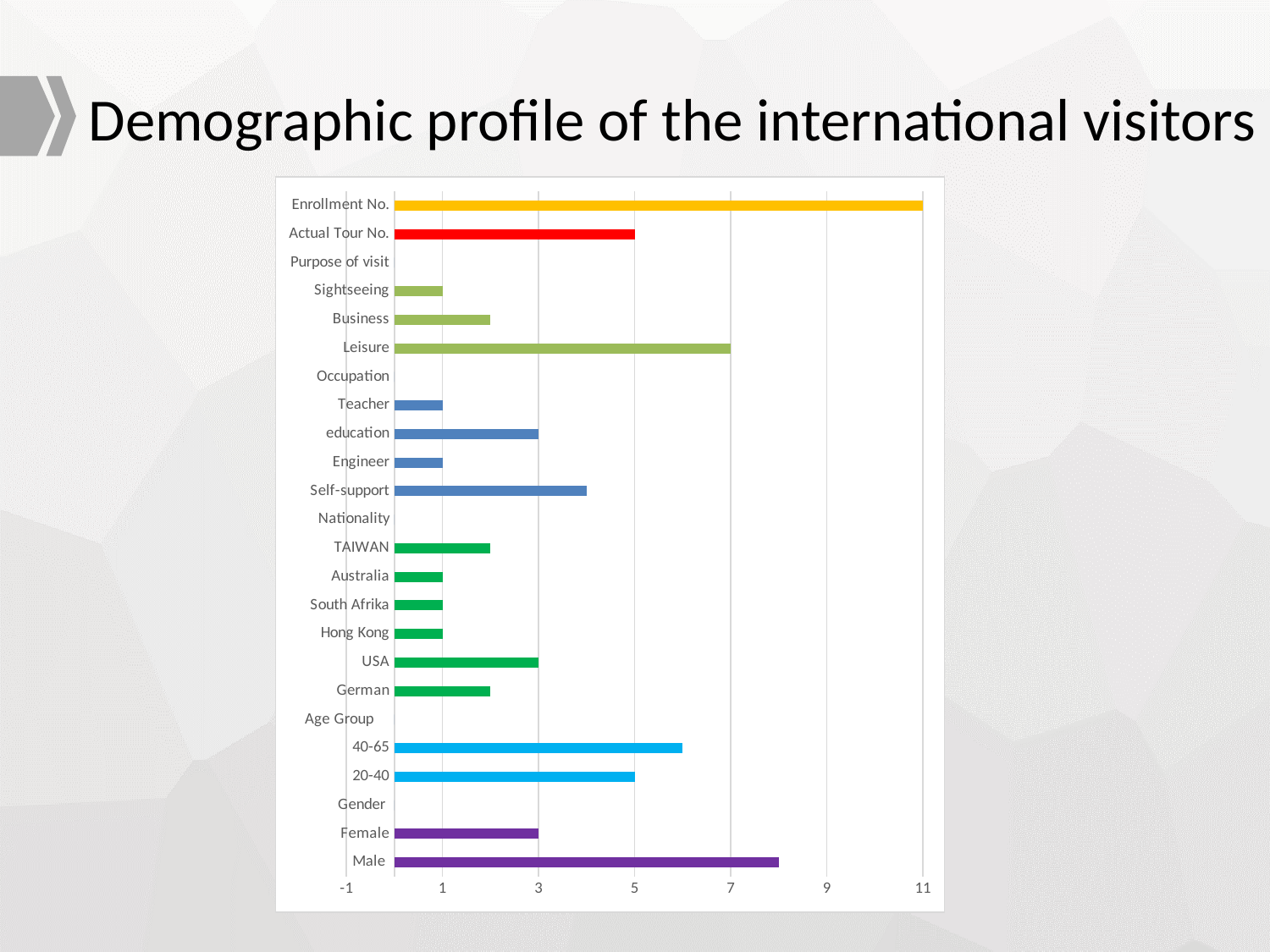
What is the value for Actual Tour No.? 5 What is the value for USA? 3 What is the difference between the value for Leisure and the value for Actual Tour No.? 2 What is the value for Leisure? 7 What is the value for Enrollment No.? 11 Is the value for Business greater or less than 3? less Is the value for Male greater or less than 7? greater Which is larger, the value for Male or the value for Female? Male What kind of chart is shown on the slide? bar chart Which category has the longest bar? Enrollment No. Is the value for 40-65 greater or less than 5? greater What colour is the bar for Actual Tour No.? red